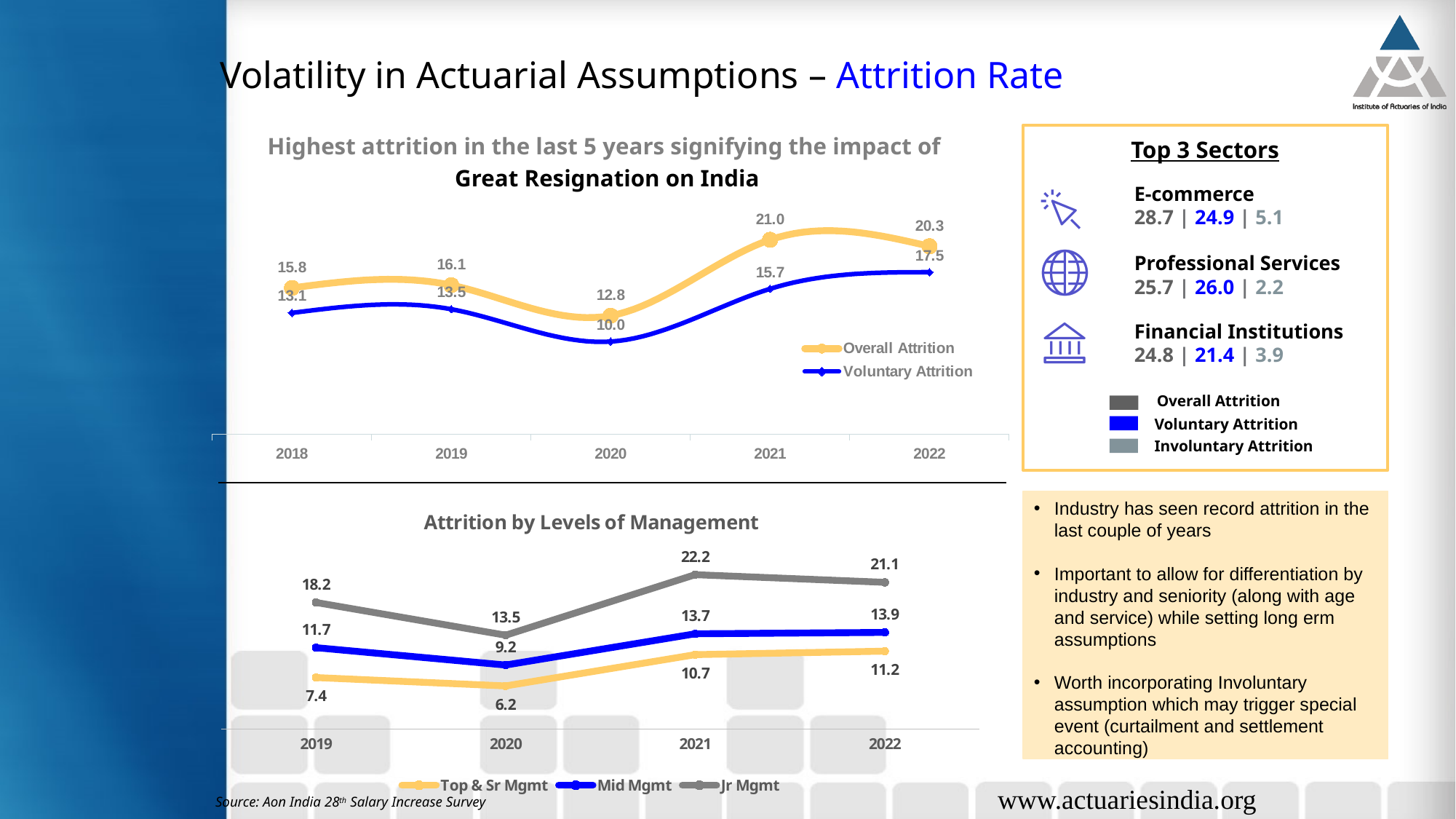
In the 'Attrition by Levels of Management' chart, which year has the lowest Top & Sr Mgmt value? 2020 In the top chart, which year has the highest Overall Attrition? 2021 What type of chart is the 'Attrition by Levels of Management' chart? Line chart In the 'Attrition by Levels of Management' chart, what is the Jr Mgmt value for 2021? 22.2 In the top chart, which year has the lowest Voluntary Attrition? 2020 In the top chart, what is the difference between Overall Attrition and Voluntary Attrition in 2022? 2.8 In the 'Attrition by Levels of Management' chart, what is the difference between the Jr Mgmt and Top & Sr Mgmt values in 2019? 10.8 In the top chart, what is the Overall Attrition value for 2021? 21.0 In the 'Attrition by Levels of Management' chart, is the Mid Mgmt value for 2022 larger or smaller than the Jr Mgmt value for 2022? Smaller How many series does the legend of the top chart list? 2 In the top chart, what is the Voluntary Attrition value for 2020? 10.0 How many years are shown on the x axis of the 'Attrition by Levels of Management' chart? 4